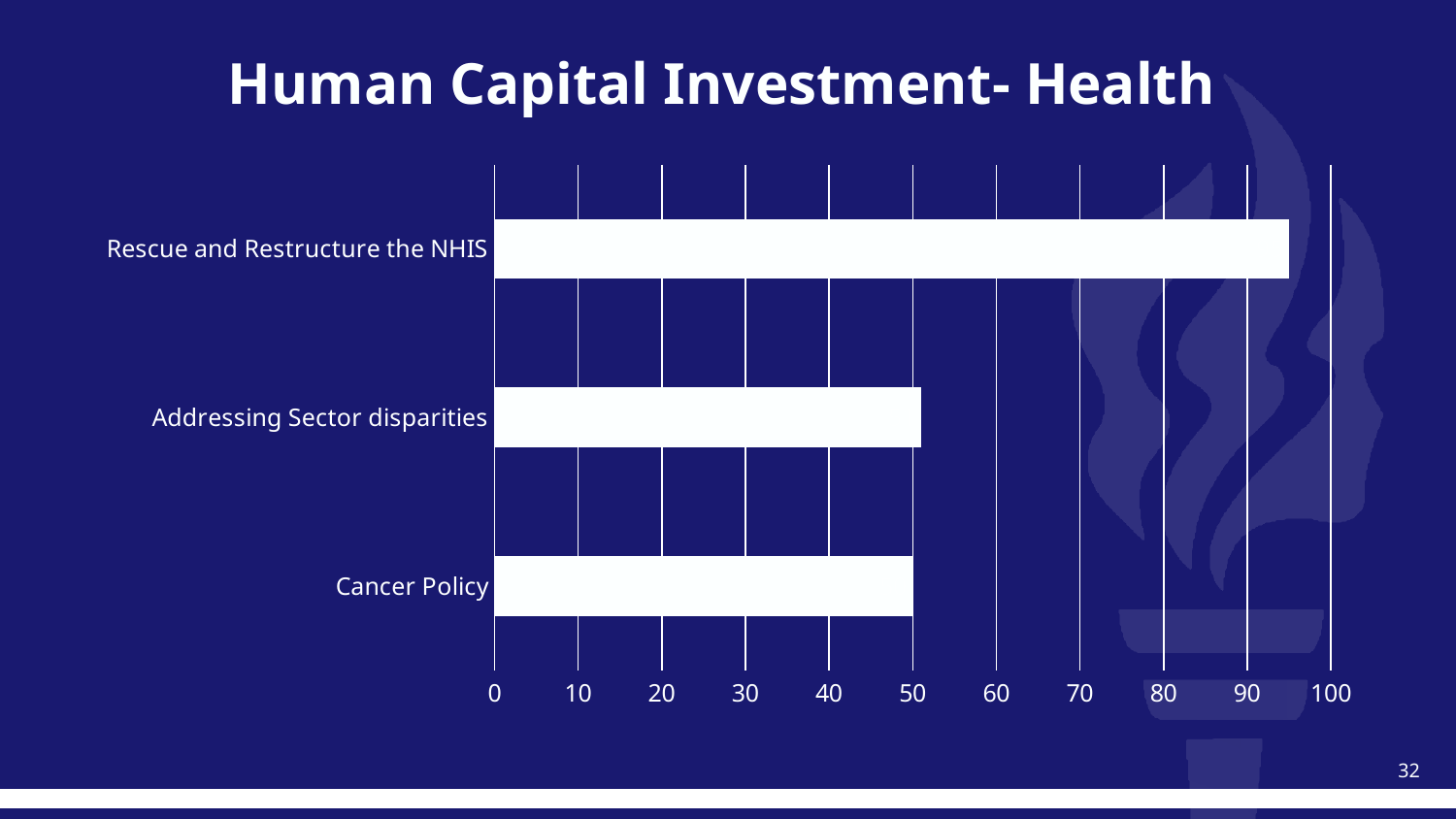
What is the title of the slide? Human Capital Investment- Health What kind of chart is shown on the slide? bar chart Is the value for Rescue and Restructure the NHIS greater or less than 100? less How many categories are plotted in the chart? 3 Which is larger, the value for Rescue and Restructure the NHIS or the value for Cancer Policy? Rescue and Restructure the NHIS Which category has the highest value? Rescue and Restructure the NHIS Is the value for Addressing Sector disparities greater or less than 60? less Is the value for Cancer Policy greater or less than 60? less What is the maximum value shown on the horizontal axis? 100 What is the value for Cancer Policy? 50